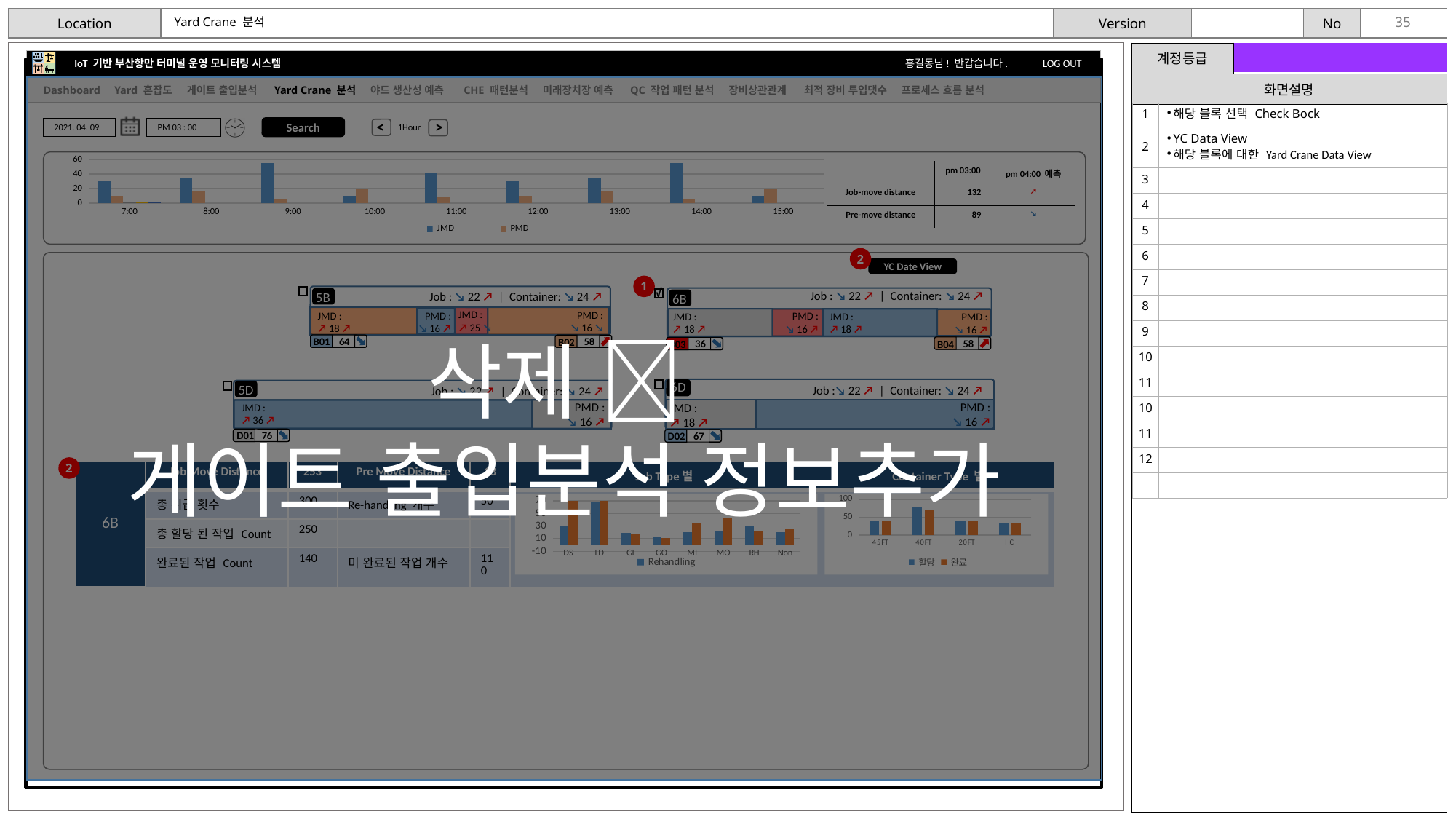
How many time categories are shown on the x axis of the top JMD/PMD chart? 9 What are the two legend entries of the bottom-right 'Container Type 별' chart? 할당, 완료 In the bottom-right 'Container Type 별' chart, is the 할당 value for 40FT greater or less than 50? greater What kind of chart is the top chart with the JMD and PMD legend? bar chart In the top chart, is the JMD value at 9:00 greater or less than 40? greater How many series does the legend of the top chart list? 2 In the top chart, is the JMD value at 10:00 greater or less than 20? less In the bottom-right 'Container Type 별' chart, how many container type categories are shown? 4 In the top chart, which is larger at 15:00, JMD or PMD? PMD In the top chart, which is larger at 7:00, JMD or PMD? JMD In the bottom-right 'Container Type 별' chart, which category has the highest 할당 value? 40FT In the bottom-middle 'Job Type 별' chart, which category has the lowest values? GO